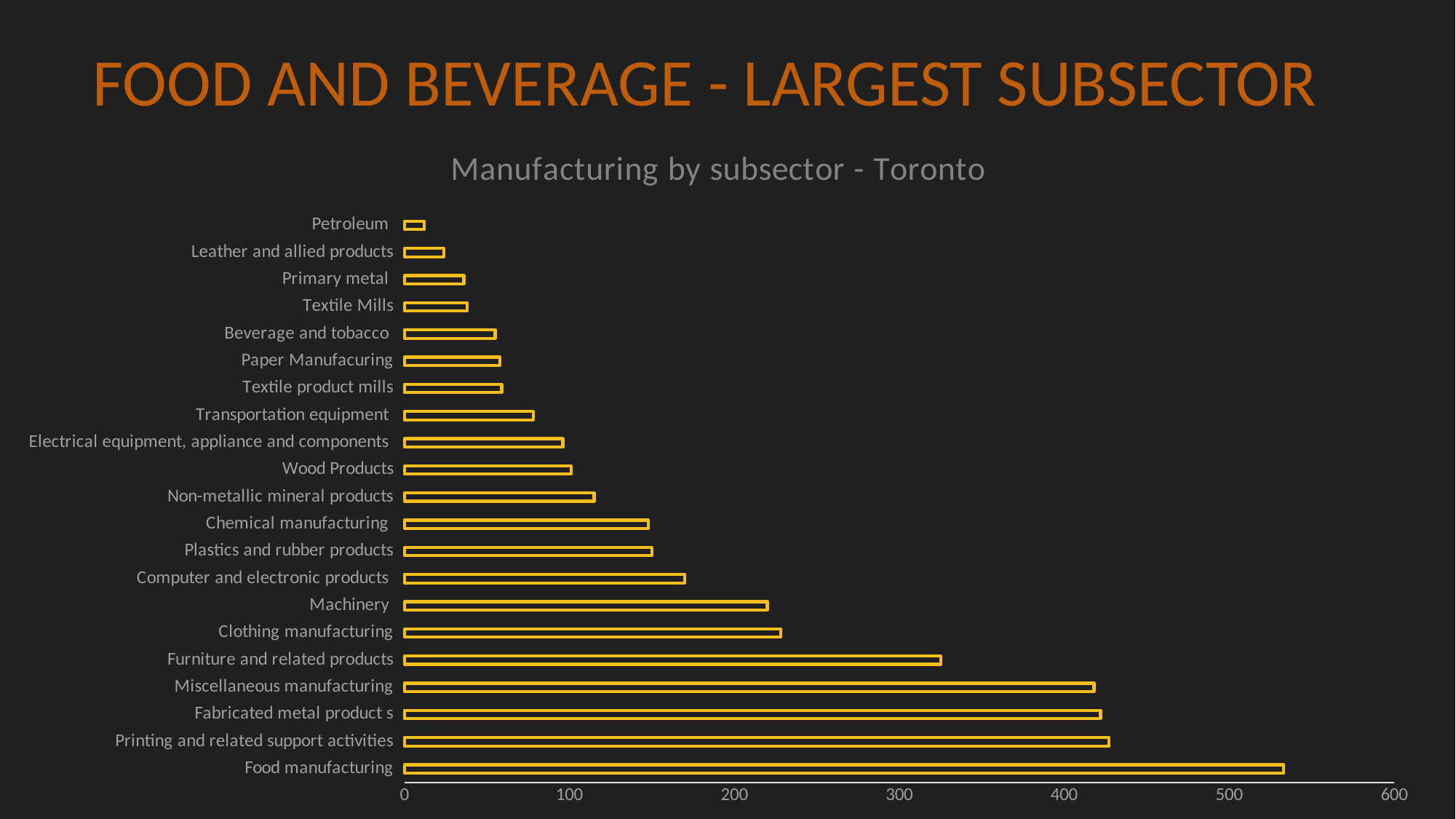
Is the value for Furniture and related products greater or less than 300? greater How many subsectors (categories) are plotted in the chart? 21 Is the value for Food manufacturing greater or less than 500? greater Which subsector has the lowest value in the chart? Petroleum Which is larger, the value for Furniture and related products or the value for Clothing manufacturing? Furniture and related products What kind of chart is shown on the slide? bar chart Is the value for Computer and electronic products greater or less than 200? less Which subsector has the highest value in the chart? Food manufacturing What is the title of the chart? Manufacturing by subsector - Toronto Which is larger, the value for Machinery or the value for Chemical manufacturing? Machinery